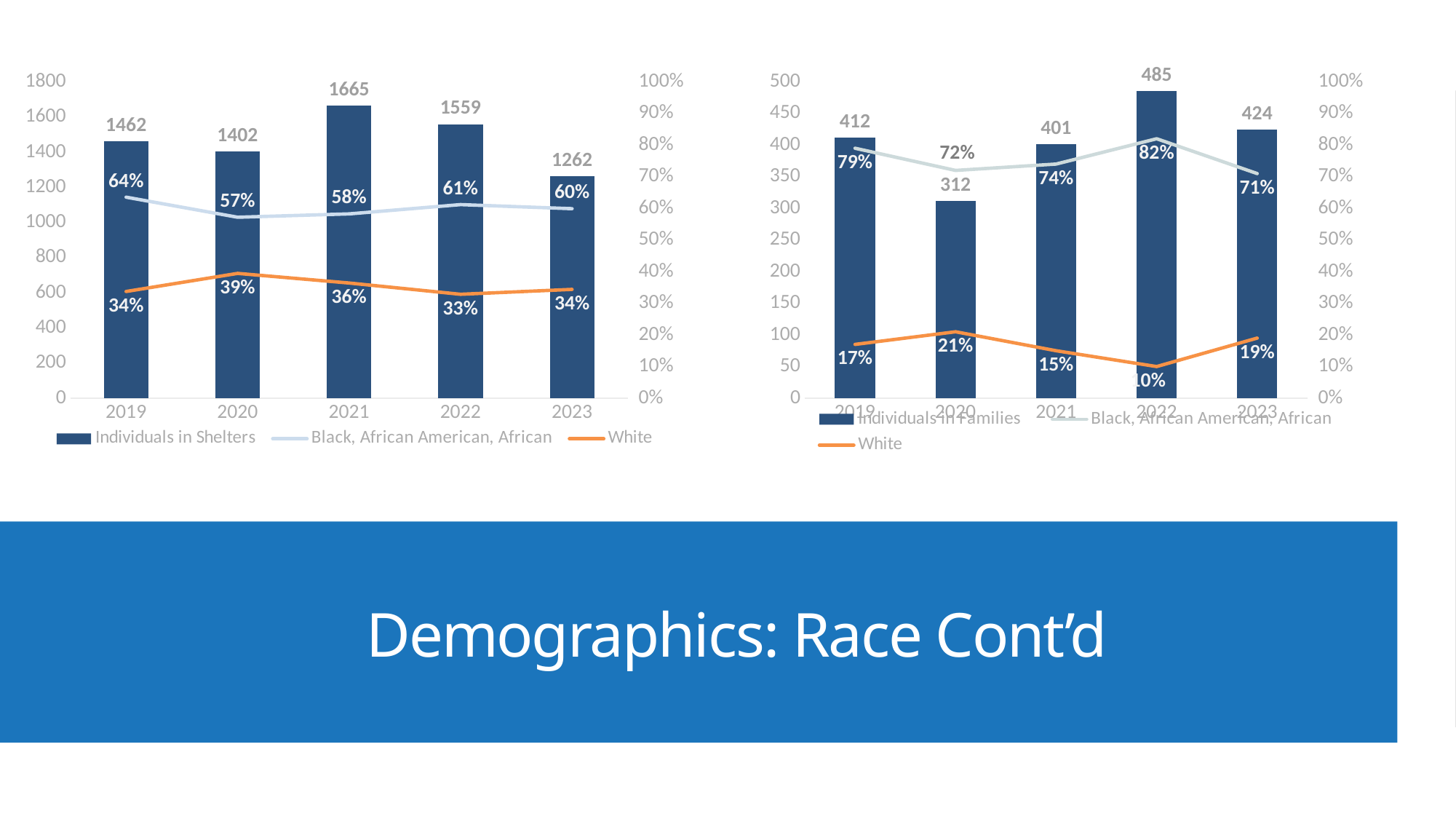
On the right chart, what is the White percentage in 2022? 10% On the left chart, which year has the highest Black, African American, African percentage? 2019 On the left chart, which year has the lowest value for Individuals in Shelters? 2023 On the right chart, which year has the lowest value for Individuals in Families? 2020 On the right chart, what is the difference between Individuals in Families in 2022 and 2020? 173 How many years are shown on the x axis of the right chart? 5 On the left chart, what is the value for Individuals in Shelters in 2021? 1665 On the left chart, what is the difference between Individuals in Shelters in 2021 and 2023? 403 On the right chart, what is the value for Individuals in Families in 2022? 485 On the right chart, is the Individuals in Families value larger in 2019 or 2023? 2023 On the left chart, what is the White percentage in 2020? 39% On the left chart, how many series does the legend list? 3